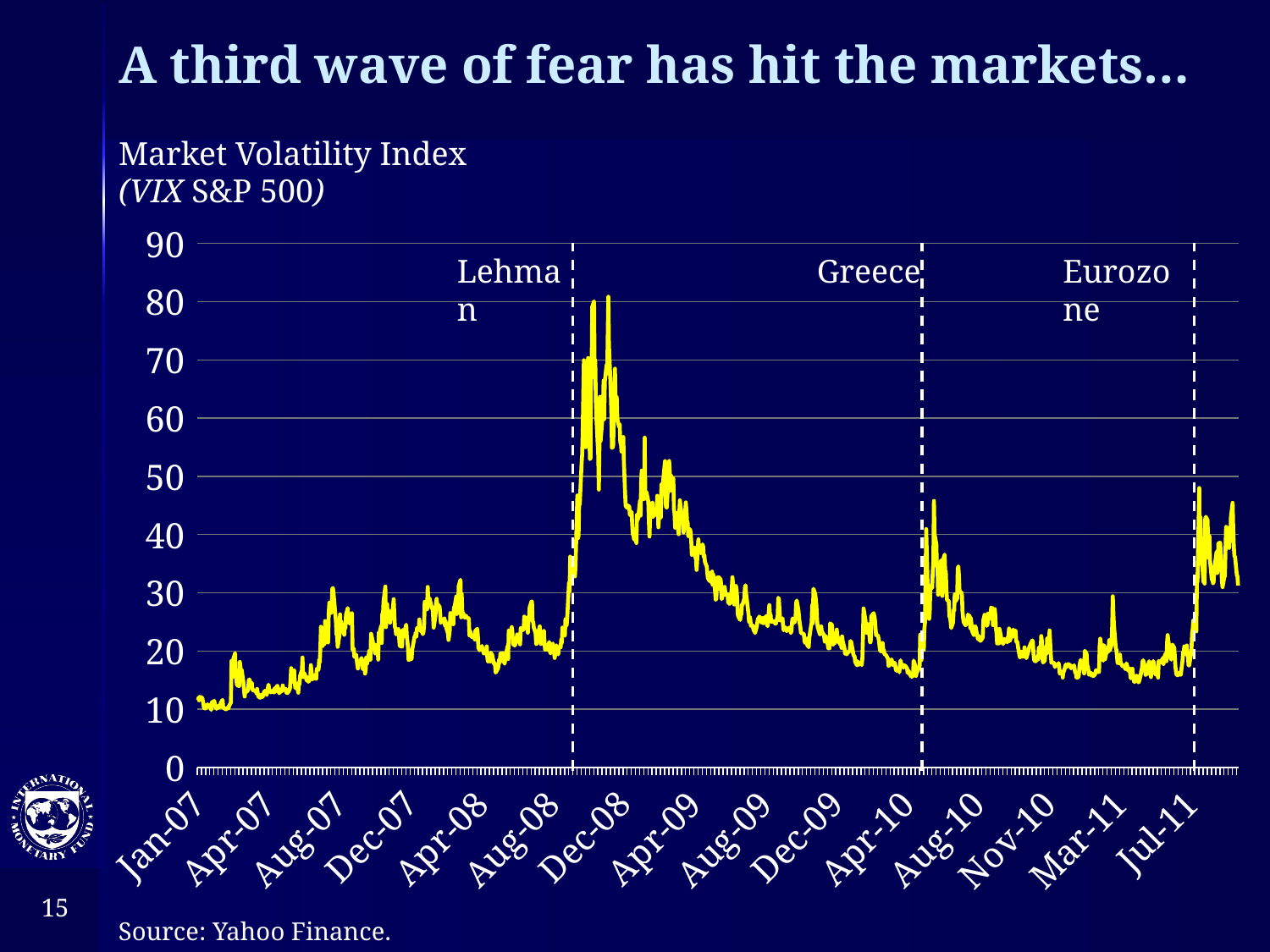
Is the peak value of the index around Dec-08 greater or less than 70? greater What kind of chart is shown on the slide? line chart Which is higher: the peak after the Lehman line or the peak after the Eurozone line? the peak after the Lehman line Around which x-axis label does the index reach its highest value? Dec-08 Between Dec-08 and Dec-09, does the index generally rise or fall? fall Is the peak of the index after the Eurozone line greater or less than 40? greater What three events are labelled by the dashed vertical lines on the chart? Lehman, Greece, Eurozone What is the title of the chart? Market Volatility Index (VIX S&P 500) How many date labels are shown on the x axis? 15 Is the peak of the index after the Greece line greater or less than 60? less